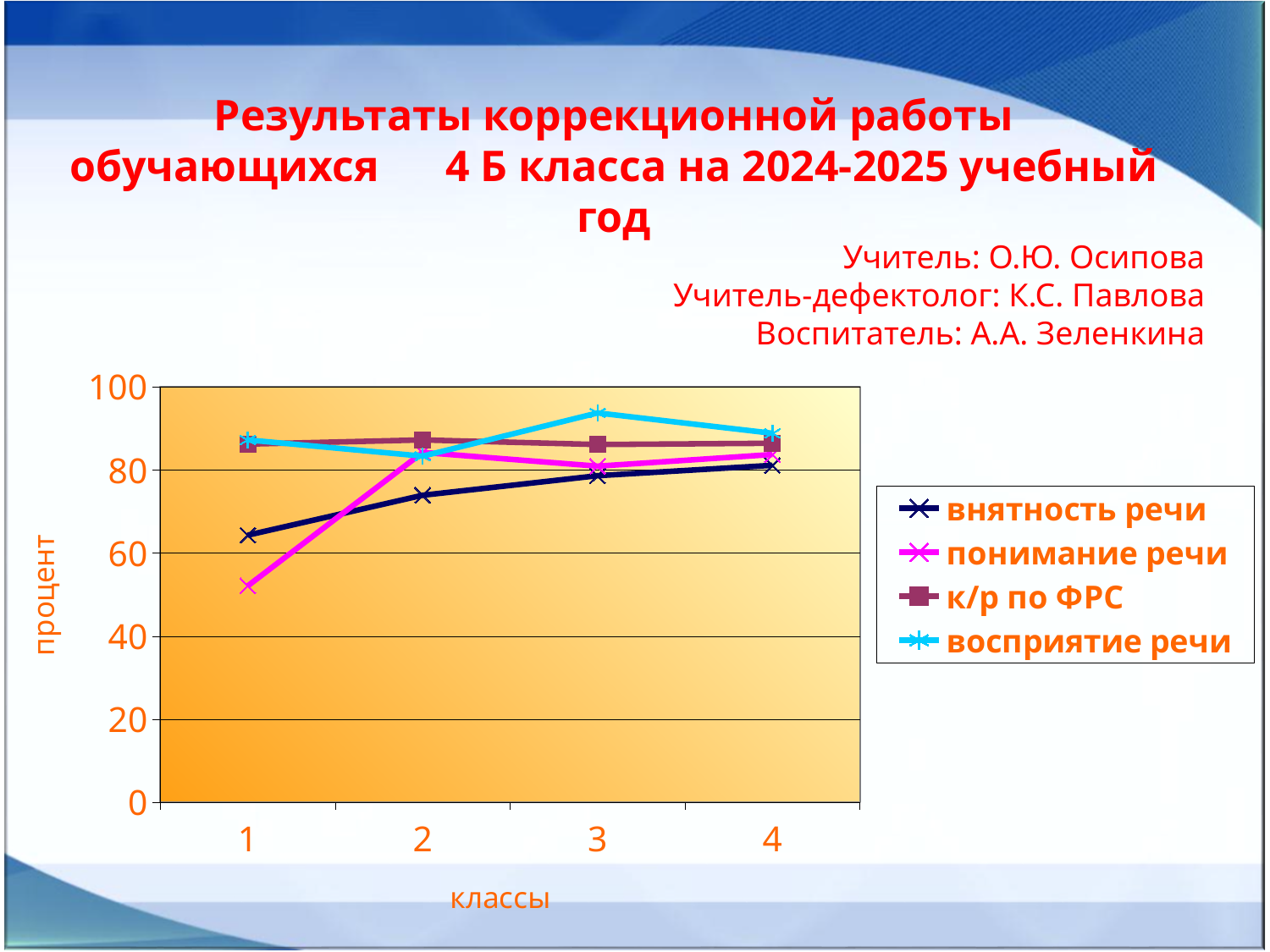
At which class is the value for понимание речи lowest? 1 Is the value for внятность речи at class 1 greater or less than 60? greater How many series does the legend list? 4 Is the value for внятность речи at class 2 greater or less than 80? less At class 3, which is larger: восприятие речи or внятность речи? восприятие речи Is the value for понимание речи at class 1 greater or less than 60? less Does the value for внятность речи rise or fall from class 1 to class 4? rises What is the title of the vertical axis? процент At class 1, which is larger: внятность речи or понимание речи? внятность речи How many classes (points) are shown along the x axis? 4 What kind of chart is shown on the slide? line chart